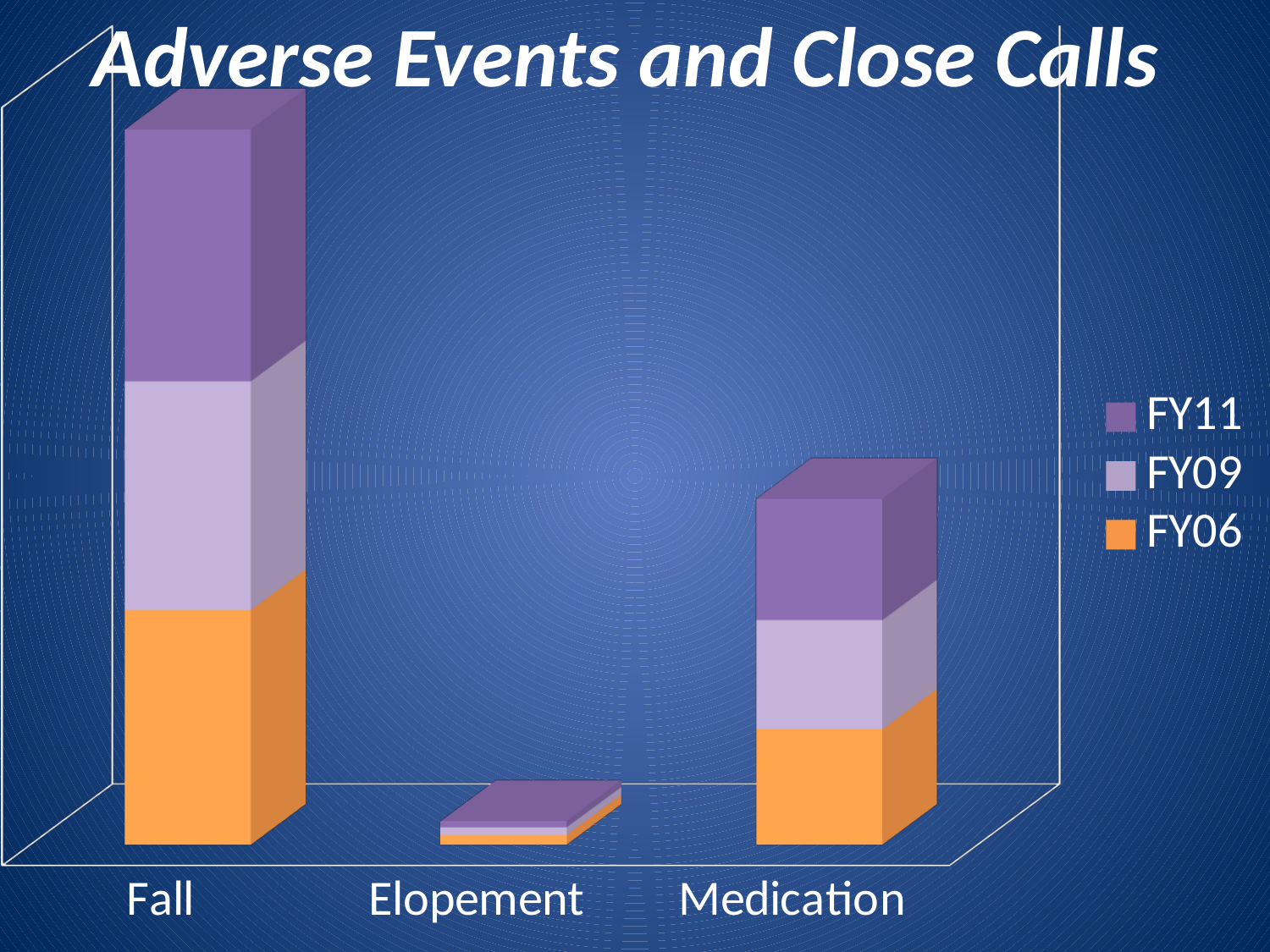
Which category has the tallest stacked bar? Fall Which series forms the bottom segment of each stacked bar? FY06 Which stacked bar is taller, Elopement or Medication? Medication What kind of chart is shown on the slide? stacked bar chart Which series is shown in orange in the legend? FY06 Which series forms the top segment of each stacked bar? FY11 Which category has the shortest stacked bar? Elopement Which stacked bar is taller, Fall or Medication? Fall How many categories are shown on the x axis of the chart? 3 How many series does the legend list? 3